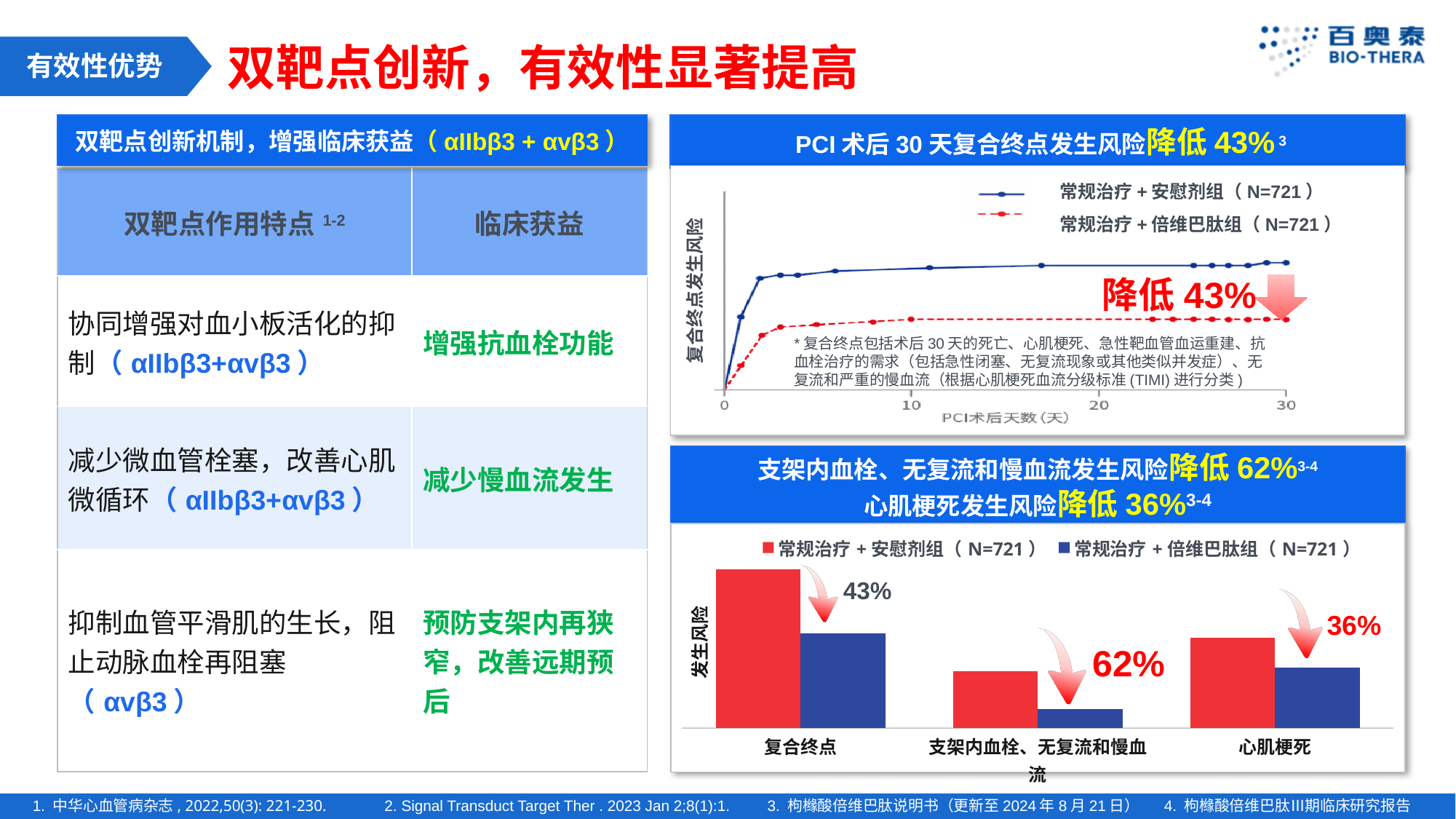
In the bottom-right bar chart, what percentage reduction is labelled for the 复合终点 category? 43% What kind of chart is the bottom-right chart on the slide? bar chart In the bottom-right bar chart, which category has the shortest 常规治疗 + 倍维巴肽组 bar? 支架内血栓、无复流和慢血流 In the bottom-right bar chart, which category has the tallest 常规治疗 + 安慰剂组 bar? 复合终点 In the bottom-right bar chart, what percentage reduction is labelled for the 支架内血栓、无复流和慢血流 category? 62% In the top-right line chart, which series has the higher line at day 30: 常规治疗 + 安慰剂组 or 常规治疗 + 倍维巴肽组? 常规治疗 + 安慰剂组 In the bottom-right bar chart, what percentage reduction is labelled for the 心肌梗死 category? 36% In the bottom-right bar chart, how many series does the legend list? 2 In the top-right line chart, how many series does the legend list? 2 In the bottom-right bar chart, how many categories are shown on the x axis? 3 In the bottom-right bar chart, for the 心肌梗死 category, which series has the taller bar: 常规治疗 + 安慰剂组 or 常规治疗 + 倍维巴肽组? 常规治疗 + 安慰剂组 What kind of chart is the top-right chart on the slide? line chart